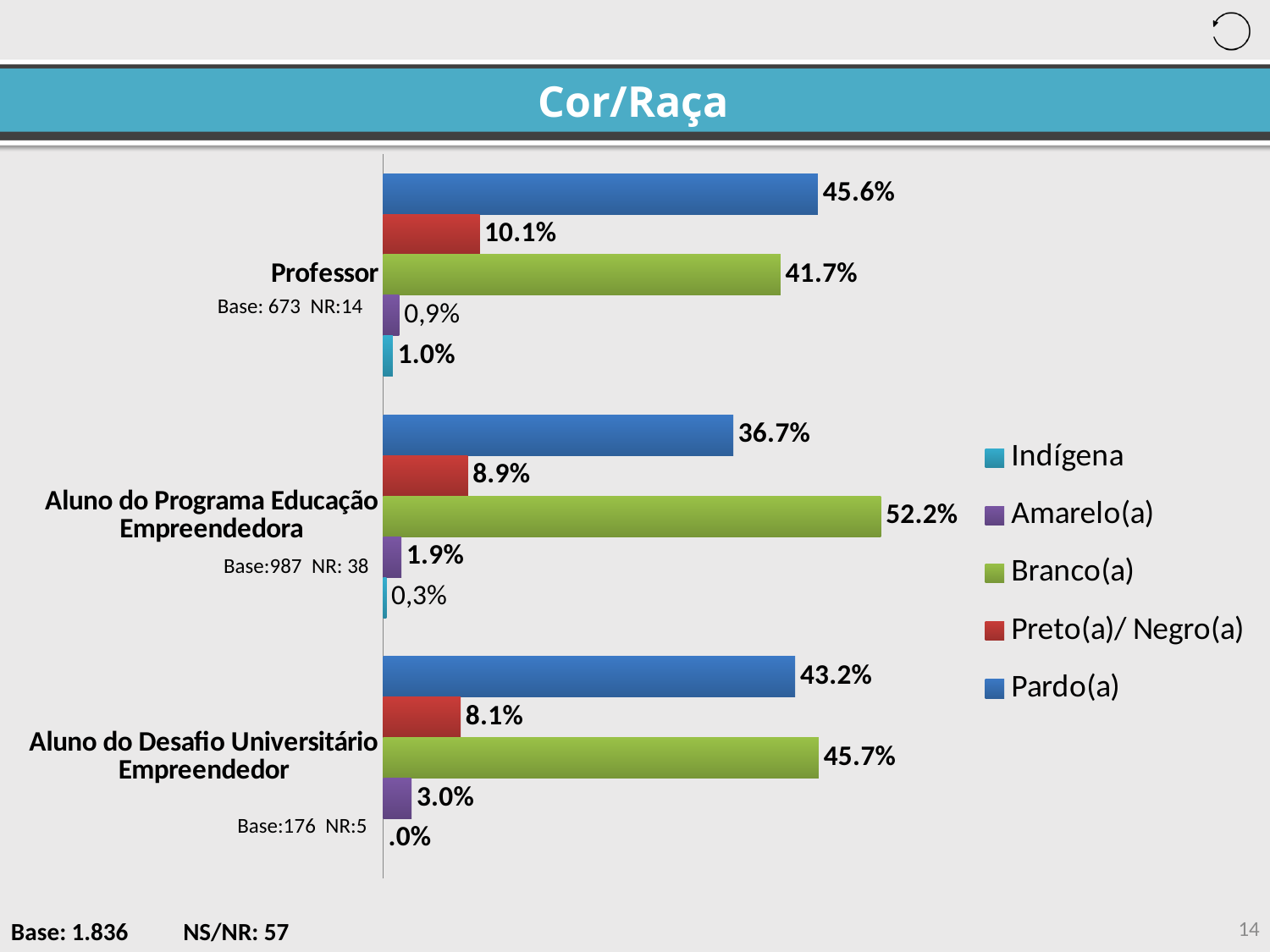
Which series has the highest value in the Aluno do Programa Educação Empreendedora category? Branco(a) How many series does the legend list? 5 What is the value for Branco(a) in the Aluno do Programa Educação Empreendedora category? 52.2% What is the value for Preto(a)/ Negro(a) in the Aluno do Desafio Universitário Empreendedor category? 8.1% What kind of chart is shown on the slide? Bar chart What is the title of the chart? Cor/Raça What is the difference between the Pardo(a) and Branco(a) values in the Professor category? 3.9% Which is larger in the Aluno do Desafio Universitário Empreendedor category: Pardo(a) or Branco(a)? Branco(a) How many categories are shown on the chart? 3 Which series has the lowest value in the Aluno do Desafio Universitário Empreendedor category? Indígena What is the value for Amarelo(a) in the Aluno do Desafio Universitário Empreendedor category? 3.0% What is the value for Pardo(a) in the Professor category? 45.6%